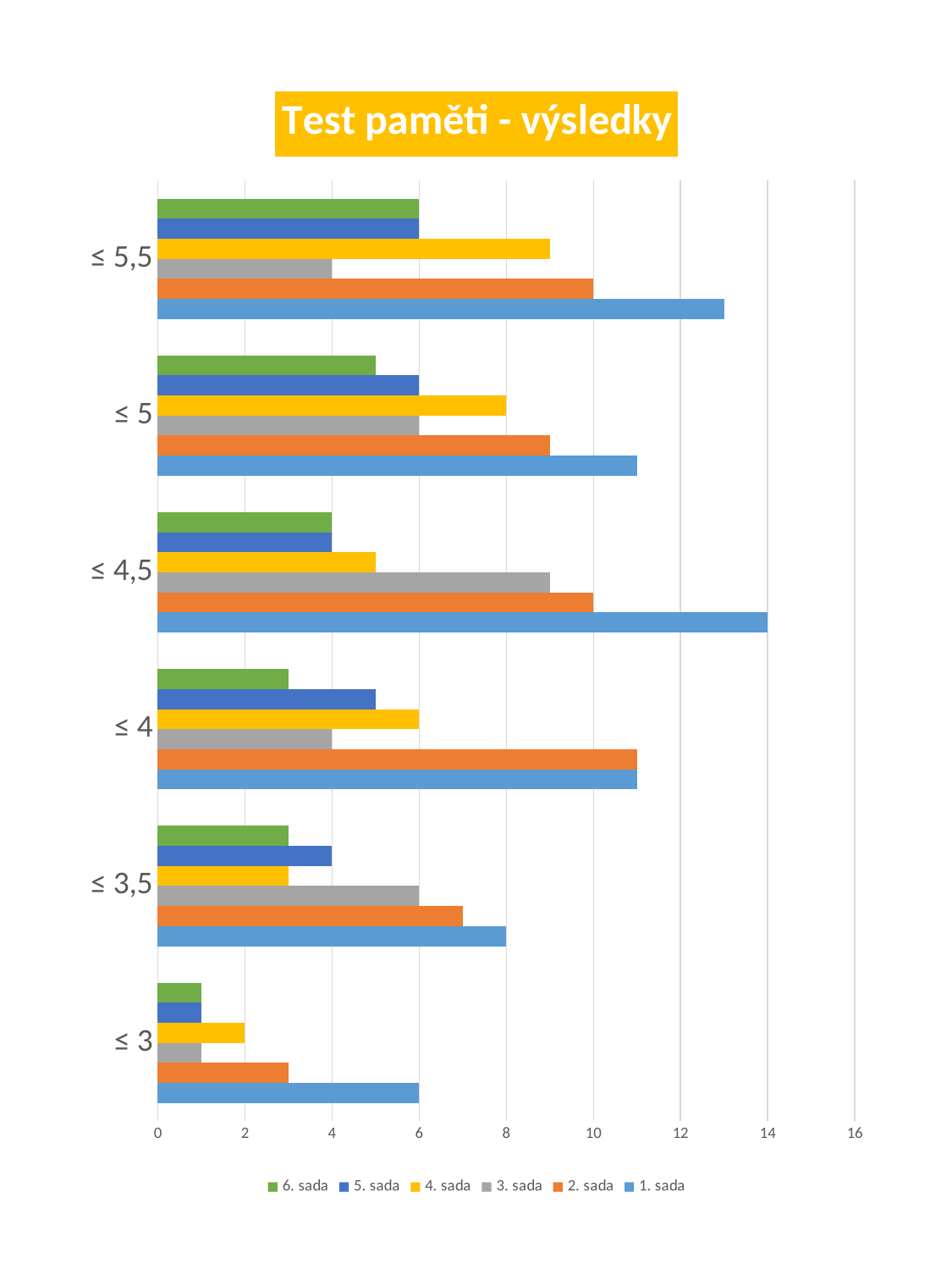
What is the value of 4. sada for the category ≤ 3? 2 How many series does the legend list? 6 What is the value of 1. sada for the category ≤ 4,5? 14 What is the value of 1. sada for the category ≤ 3? 6 Which category has the highest value for 1. sada? ≤ 4,5 Which category has the lowest value for 2. sada? ≤ 3 How many categories are shown on the vertical axis? 6 For the category ≤ 4,5, which is larger: the value of 3. sada or the value of 4. sada? 3. sada What is the title of the chart? Test paměti - výsledky What kind of chart is shown on the slide? bar chart What is the value of 2. sada for the category ≤ 5,5? 10 Is the value of 1. sada for the category ≤ 5,5 greater or less than 12? greater